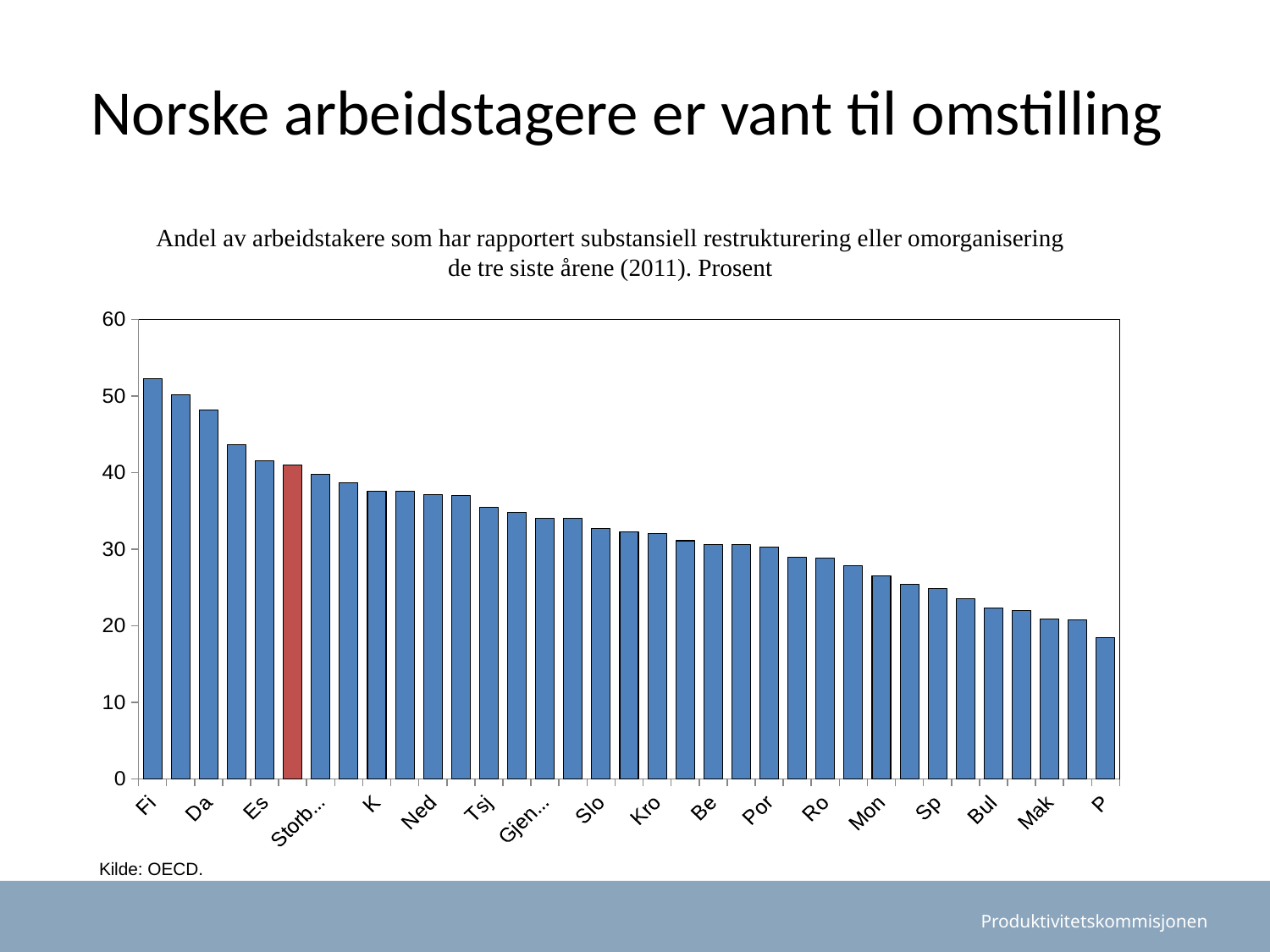
What source is cited below the chart? OECD Which is larger, the value for Es or the value for Mon? Es Is the value for P greater or less than 20? less Is the value for Ned greater or less than 30? greater Is the value for Da greater or less than 40? greater Do the values rise or fall from left to right along the x axis? fall Which category has the highest value? Fi What kind of chart is shown on the slide? bar chart Which category has the lowest value? P Which is larger, the value for Slo or the value for Da? Da